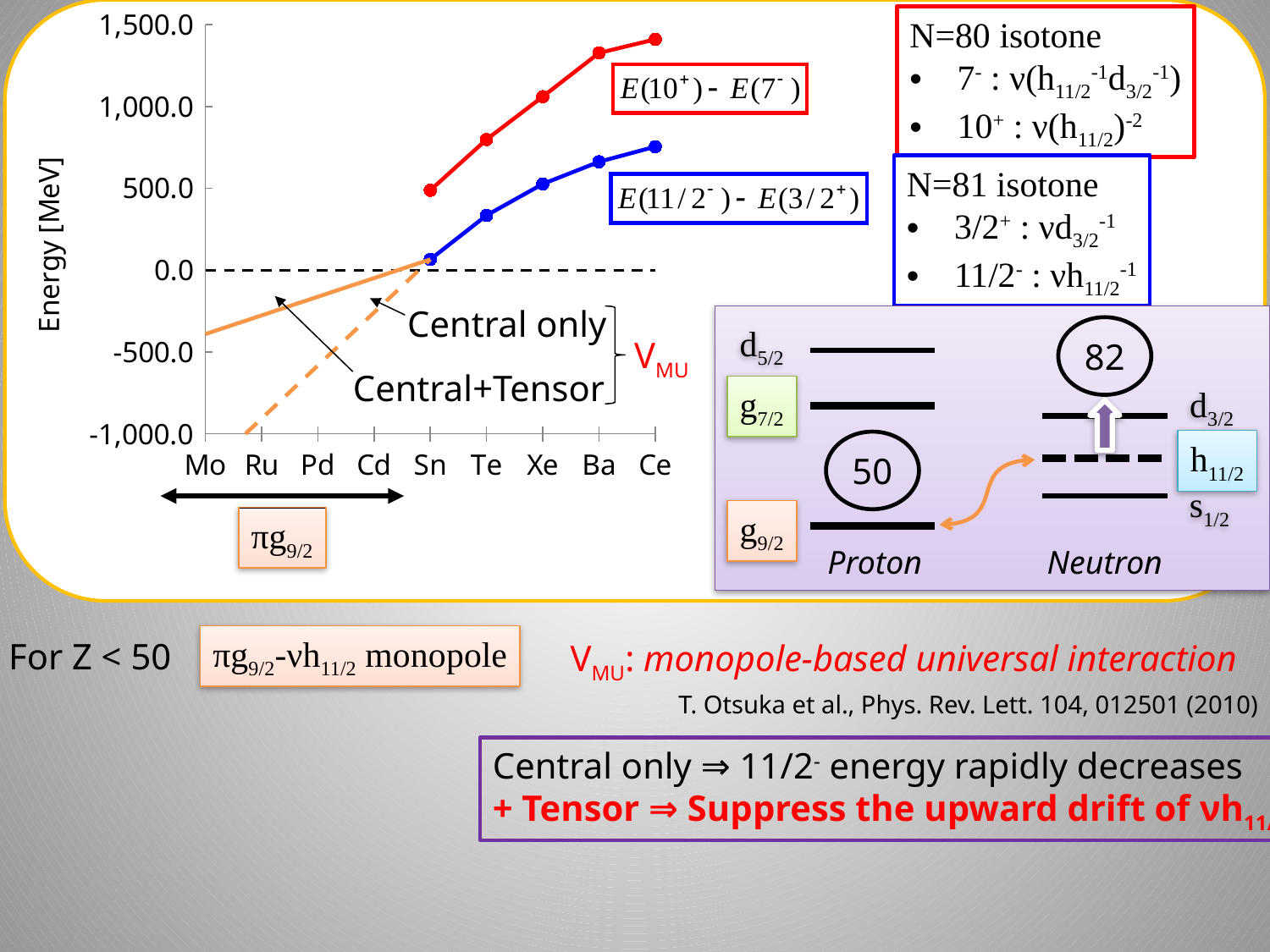
Does the E(10+) - E(7-) series rise or fall from Sn to Ce? rise At which category does the E(11/2-) - E(3/2+) series reach its lowest value? Sn What kind of chart is shown on the slide? line chart Is the value of the E(11/2-) - E(3/2+) series at Ce greater or less than 1,000.0? less Is the value of the E(10+) - E(7-) series at Te greater or less than 500.0? greater What is the label of the y axis of the chart? Energy [MeV] Is the value of the E(10+) - E(7-) series at Ce greater or less than 1,000.0? greater At Ce, which series has the larger value: E(10+) - E(7-) or E(11/2-) - E(3/2+)? E(10+) - E(7-) Does the E(11/2-) - E(3/2+) series rise or fall from Sn to Ce? rise At Ru, which line is lower: Central only or Central+Tensor? Central only How many categories are labelled on the x axis of the chart? 9